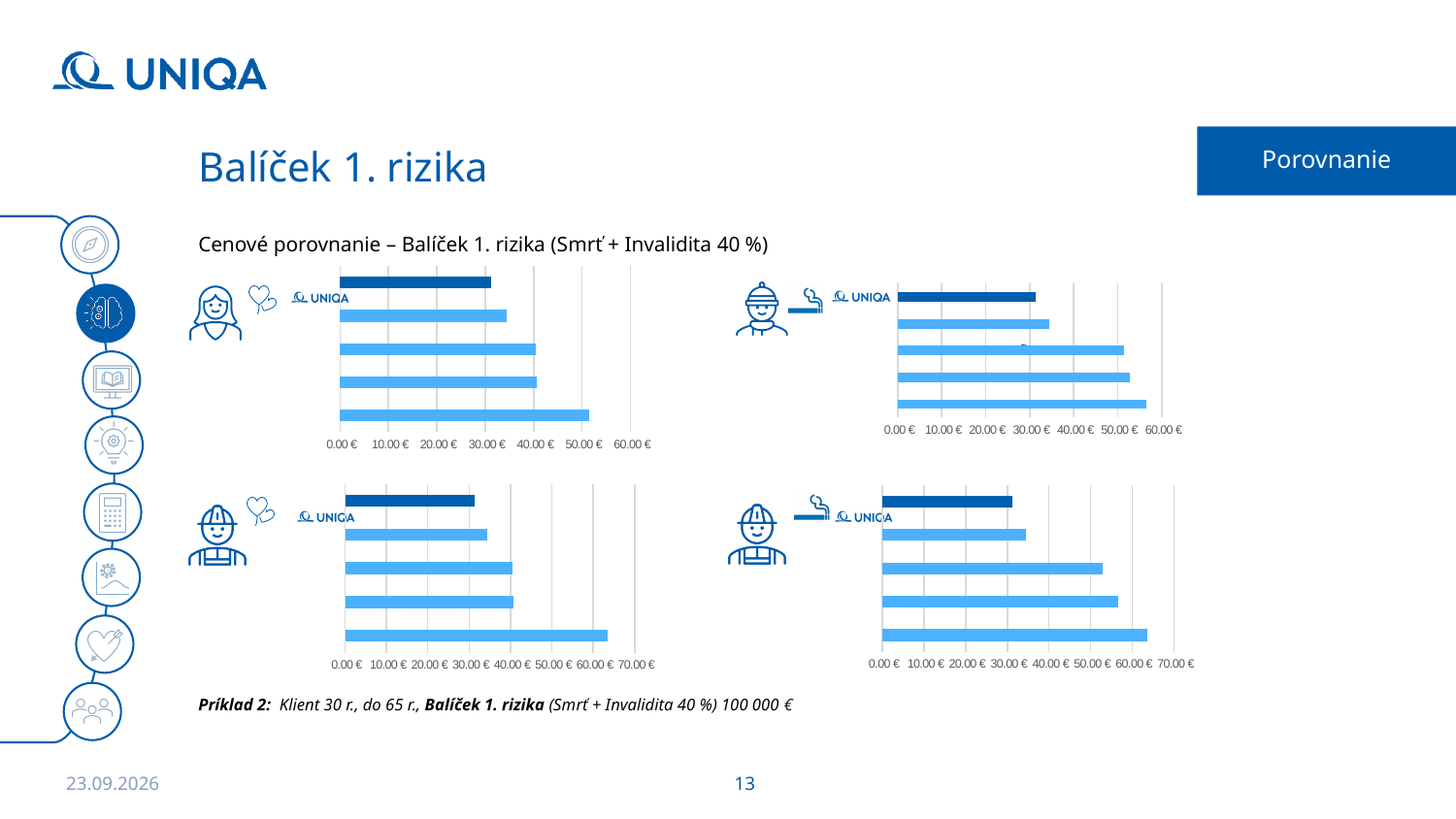
In the bottom-left chart, is the bottom bar longer or shorter than the top (UNIQA) bar? longer In the top-left chart, which bar is the longest? the bottom bar In the bottom-left chart, is the value of the bottom bar greater or less than 60.00 €? greater In the top-left chart, is the value of the top (UNIQA) bar greater or less than 40.00 €? less In the bottom-right chart, is the value of the top (UNIQA) bar greater or less than 40.00 €? less In the top-right chart, which bar is drawn in dark blue? the top (UNIQA) bar What kind of chart is the top-left chart on the slide? bar chart How many bar charts are shown on the slide? 4 How many bars does the top-left chart contain? 5 What is the highest value shown on the x axis of the bottom-left chart? 70.00 € In the bottom-right chart, which bar is the shortest? the top (UNIQA) bar